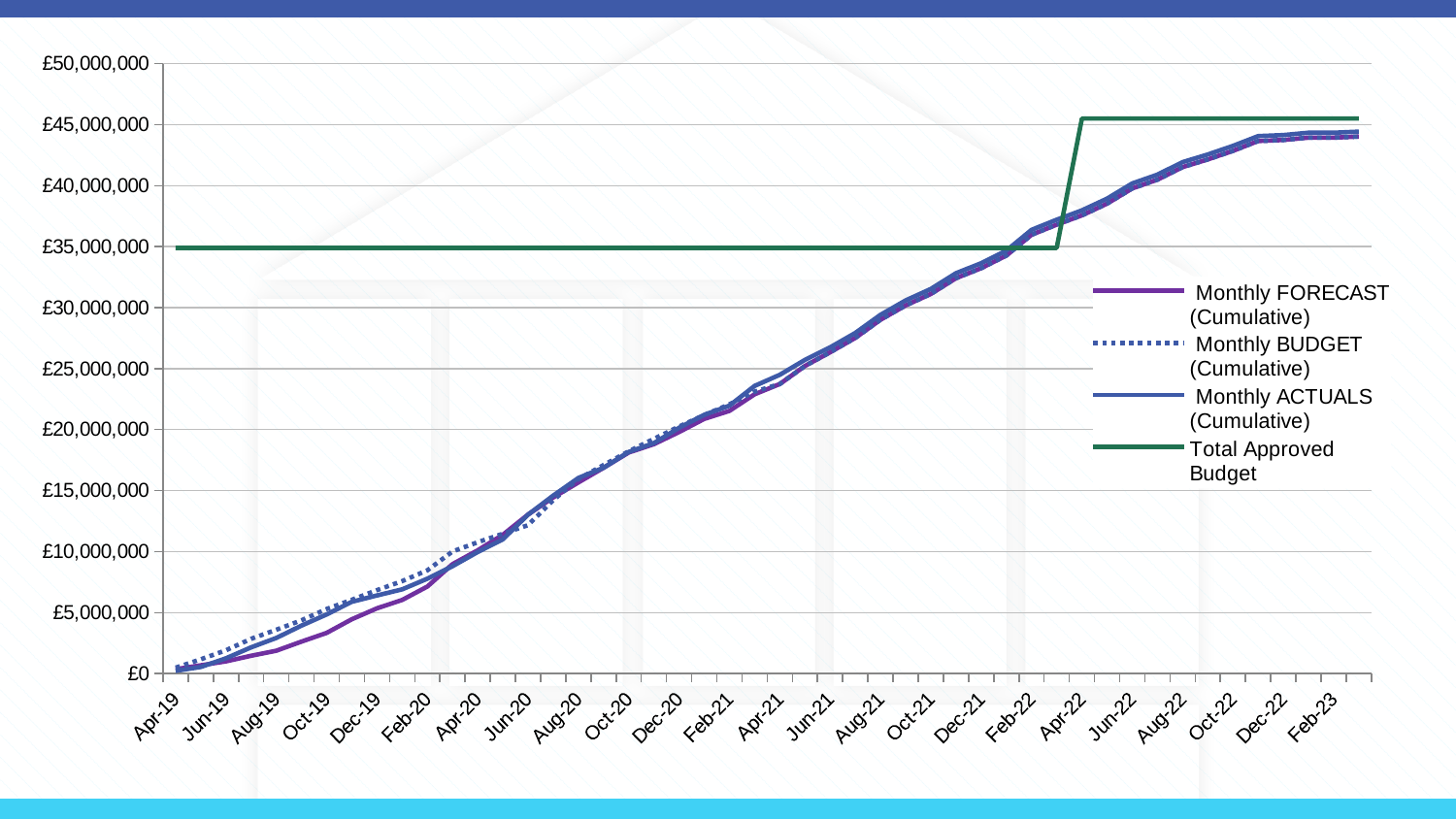
Which series is drawn with a dotted line? Monthly BUDGET (Cumulative) Is the value of Total Approved Budget at Apr-19 greater or less than £40,000,000? less Does the Monthly ACTUALS (Cumulative) line rise or fall from Apr-19 to Feb-23? Rise Is the value of Monthly ACTUALS (Cumulative) at Oct-20 greater or less than £15,000,000? greater Is the value of Monthly FORECAST (Cumulative) at Apr-19 greater or less than £5,000,000? less How many series does the legend list? 4 At Feb-23, which is larger: Total Approved Budget or Monthly ACTUALS (Cumulative)? Total Approved Budget At Apr-19, which is larger: Total Approved Budget or Monthly ACTUALS (Cumulative)? Total Approved Budget What colour is the Total Approved Budget line? Green What kind of chart is shown on the slide? Line chart